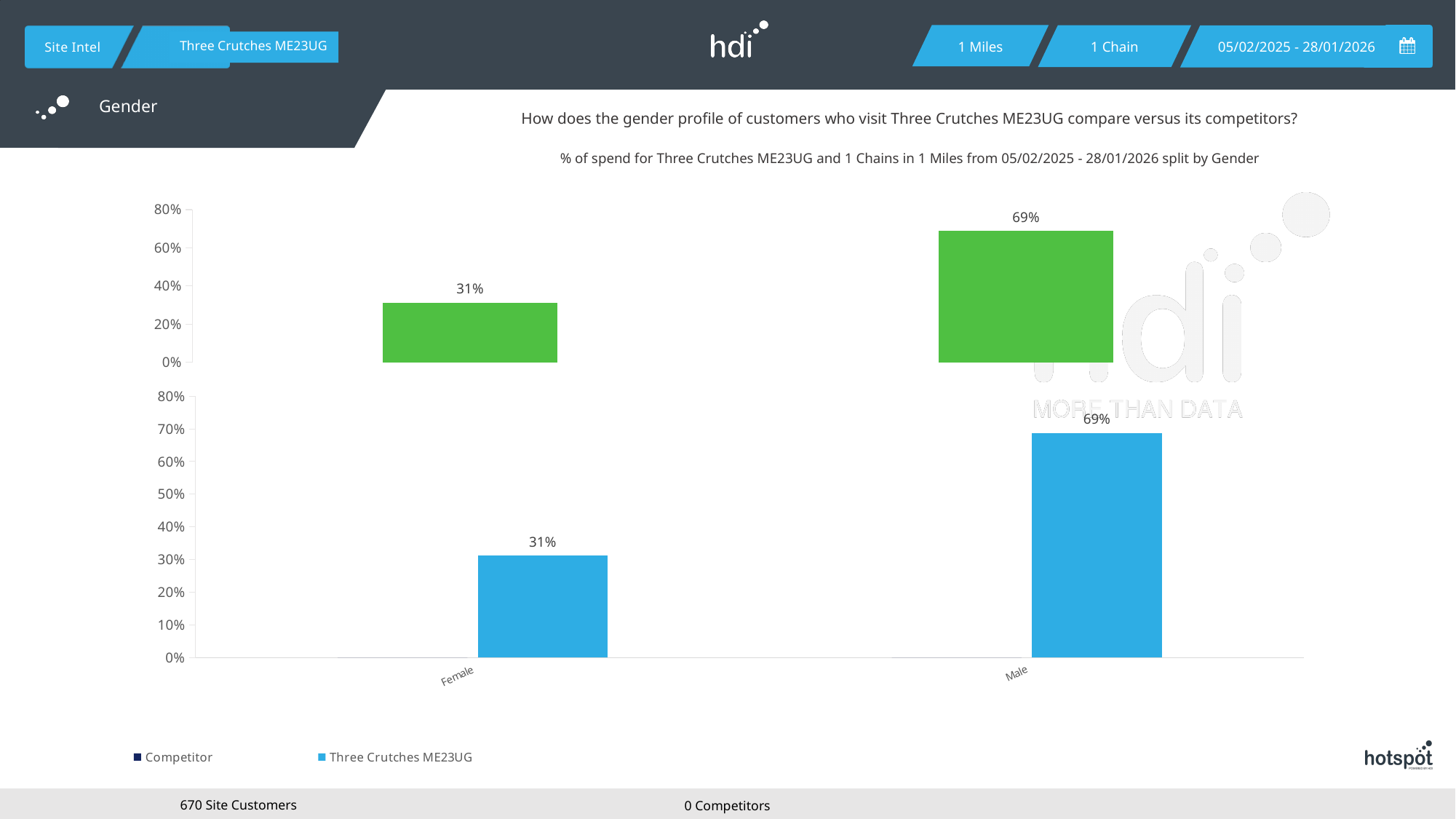
In the bottom chart, what is the value for Male? 69% How many categories are shown on the x axis of the bottom chart? 2 In the bottom chart, is the value for Male greater or less than 60%? greater What kind of chart is the bottom chart? bar chart How many series does the legend at the bottom of the slide list? 2 In the bottom chart, what is the difference between the Male and Female values? 38% In the bottom chart, what is the value for Female? 31% In the bottom chart, which category has the highest value? Male In the top chart, what is the value for the Female bar? 31% In the top chart, what is the value for the Male bar? 69% In the bottom chart, which category has the lowest value? Female In the top chart, which is larger, the Female bar or the Male bar? Male